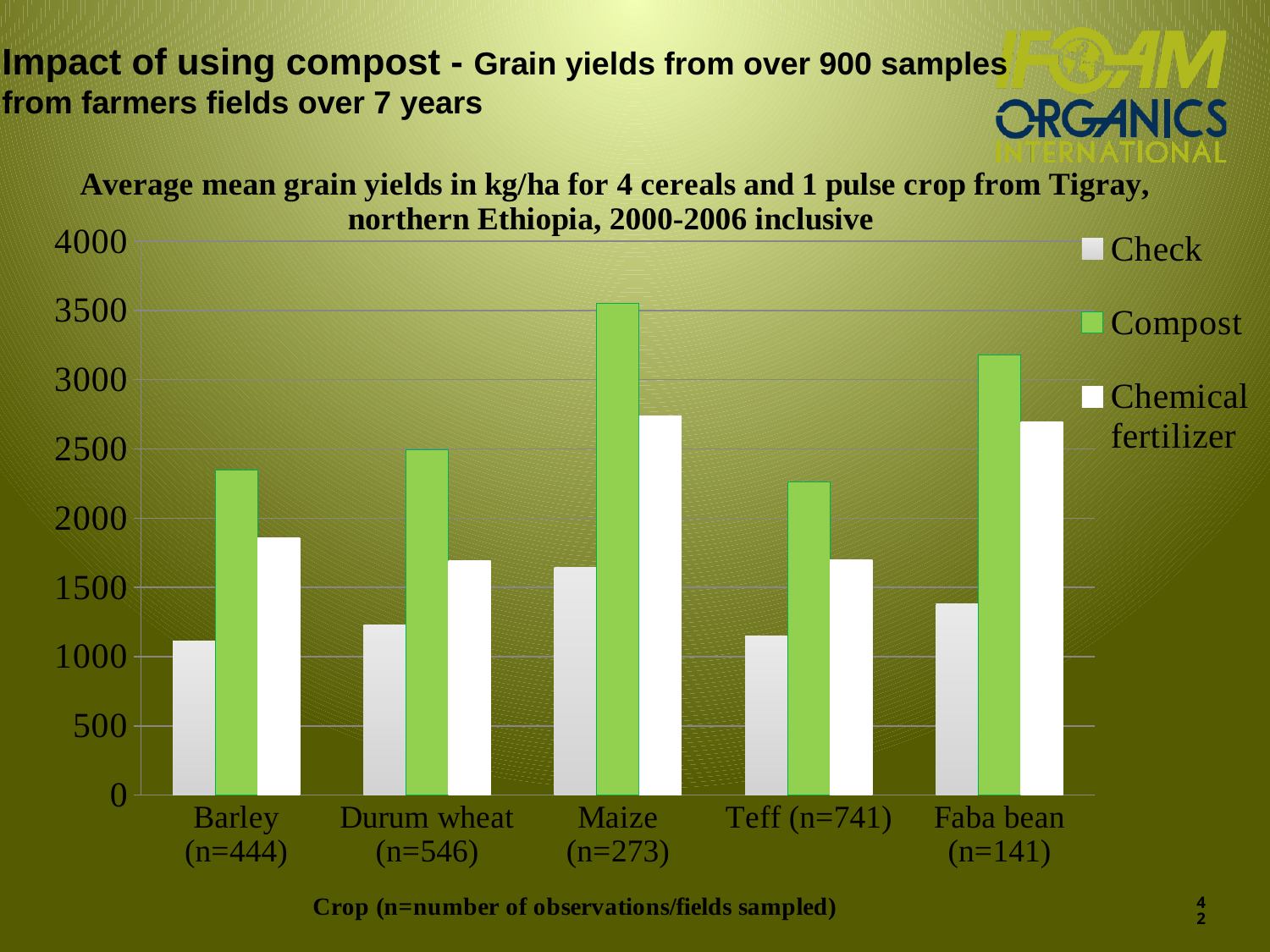
Which is larger: the Check yield for Maize or the Check yield for Faba bean? Maize Is the Compost value for Maize greater or less than 3000? greater Is the Compost value for Faba bean greater or less than 3000? greater Is the Check value for Barley greater or less than 1500? less How many crops are shown on the x axis of the chart? 5 Which crop has the highest Check yield? Maize (n=273) What is the title of the chart's x axis? Crop (n=number of observations/fields sampled) For Maize, which is larger: the Compost yield or the Chemical fertilizer yield? Compost What kind of chart is shown on the slide? bar chart Which crop has the highest Compost yield? Maize (n=273) How many series does the chart's legend list? 3